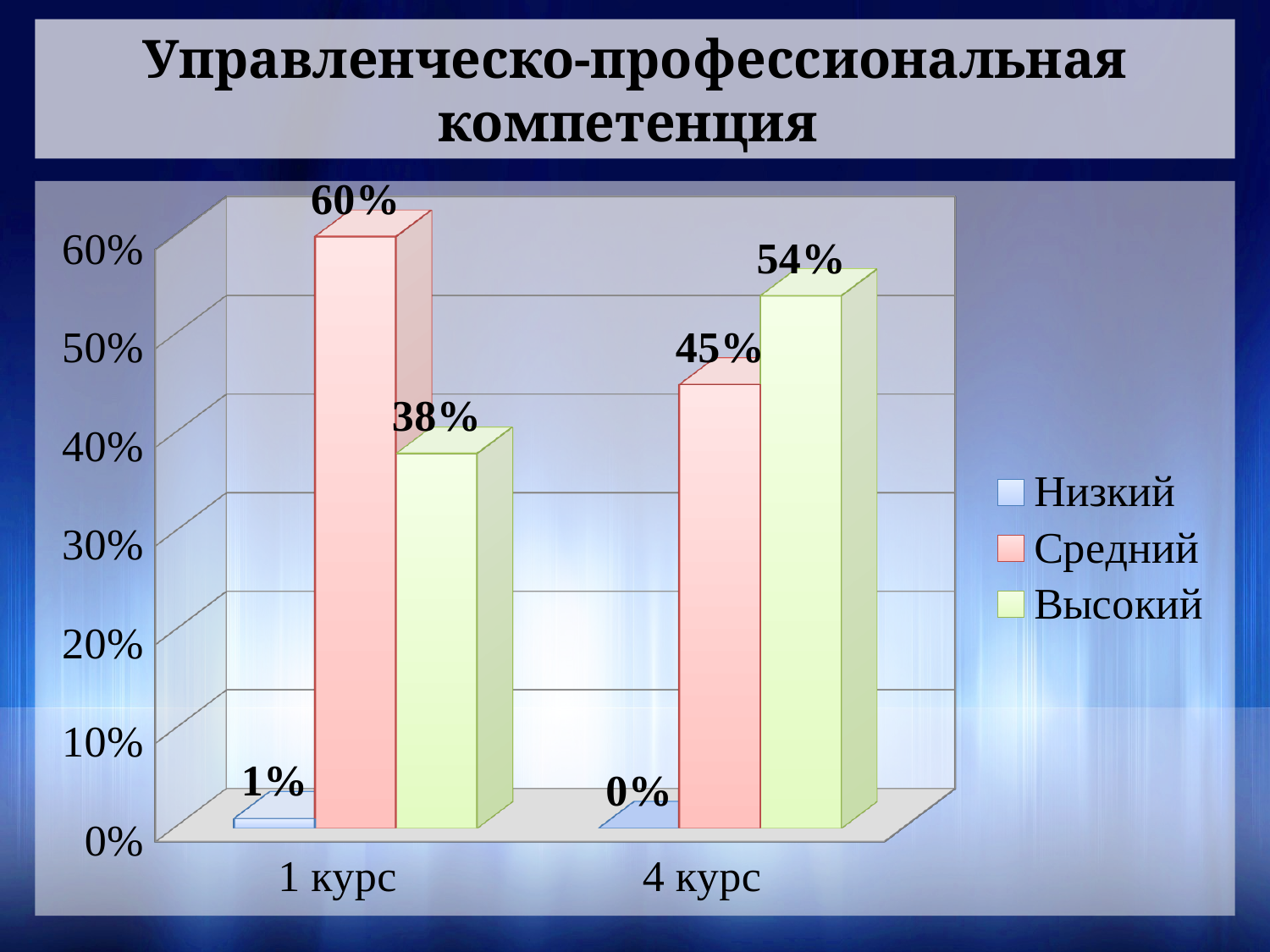
How many series does the legend list? 3 How many categories are shown on the x axis? 2 What kind of chart is shown on the slide? Bar chart What is the difference between the Средний values for 1 курс and 4 курс? 15% What is the value for Средний in 4 курс? 45% What is the title of the slide? Управленческо-профессиональная компетенция What is the value for Средний in 1 курс? 60% What is the value for Низкий in 1 курс? 1% What is the value for Высокий in 4 курс? 54% Which series has the lowest value in 4 курс? Низкий Which is larger: Высокий in 1 курс or Высокий in 4 курс? Высокий in 4 курс Which series has the highest value in 1 курс? Средний